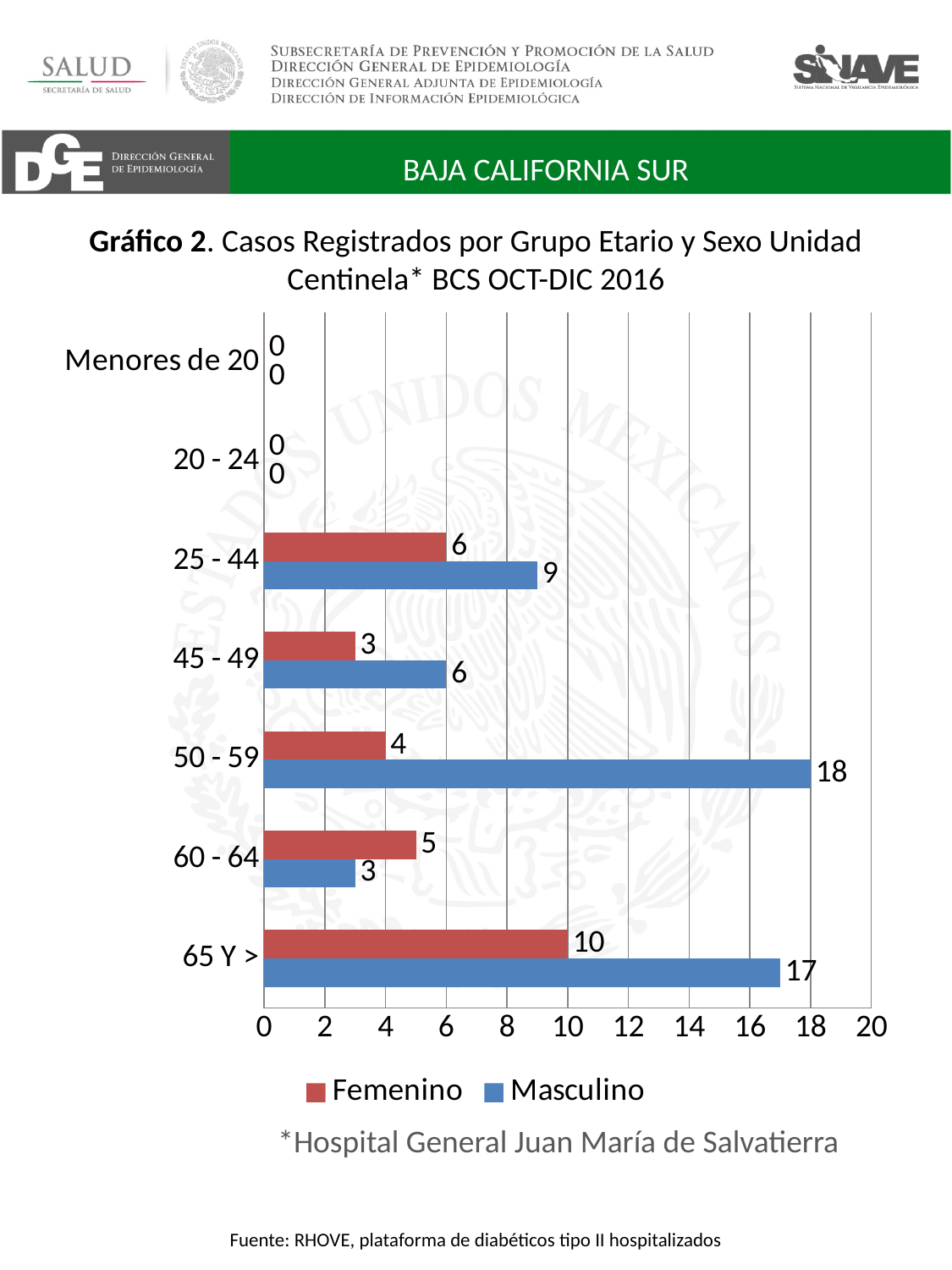
What kind of chart is shown? Bar chart How many age groups are shown on the chart? 7 For the 60 - 64 age group, which is larger, Femenino or Masculino? Femenino How many series does the legend list? 2 What is the Masculino value for the 50 - 59 age group? 18 What is the Femenino value for the 65 Y > age group? 10 Which age group has the highest Femenino value? 65 Y > What is the difference between the Masculino and Femenino values for the 50 - 59 age group? 14 Which colour represents the Masculino series? Blue What is the total of Femenino and Masculino for the 25 - 44 age group? 15 Which age group has the highest Masculino value? 50 - 59 What is the Femenino value for the 45 - 49 age group? 3